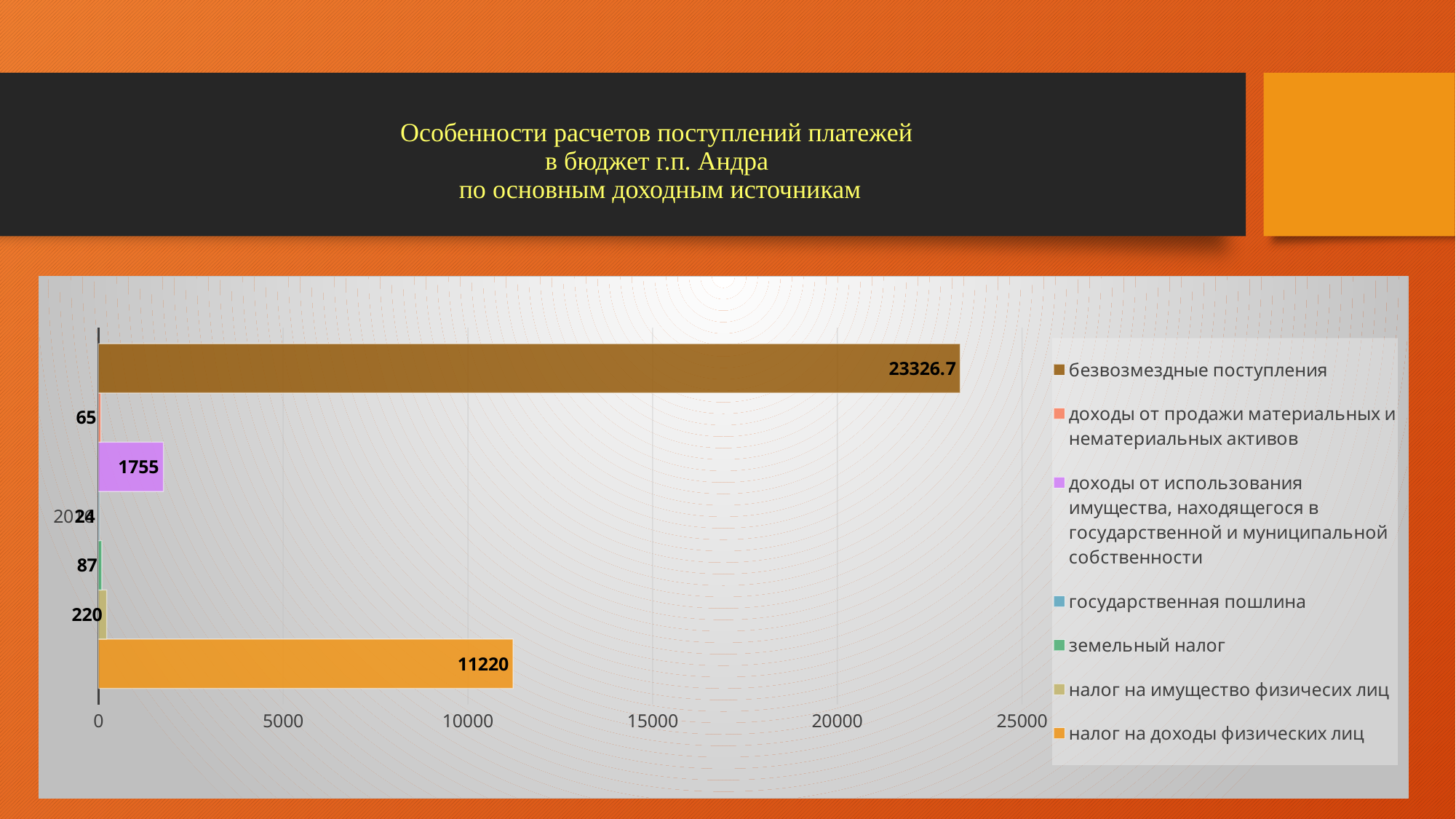
Is the value for налог на доходы физических лиц greater or less than 10000? greater How many series does the legend list? 7 What is the difference between безвозмездные поступления and налог на доходы физических лиц? 12106.7 What is the value for доходы от продажи материальных и нематериальных активов? 65 What is the value for доходы от использования имущества, находящегося в государственной и муниципальной собственности? 1755 Which series has the highest value? безвозмездные поступления What is the value for налог на имущество физичесих лиц? 220 What is the value for безвозмездные поступления? 23326.7 What kind of chart is shown on the slide? bar chart What is the value for налог на доходы физических лиц? 11220 What is the value for земельный налог? 87 Which is larger: земельный налог or налог на имущество физичесих лиц? налог на имущество физичесих лиц